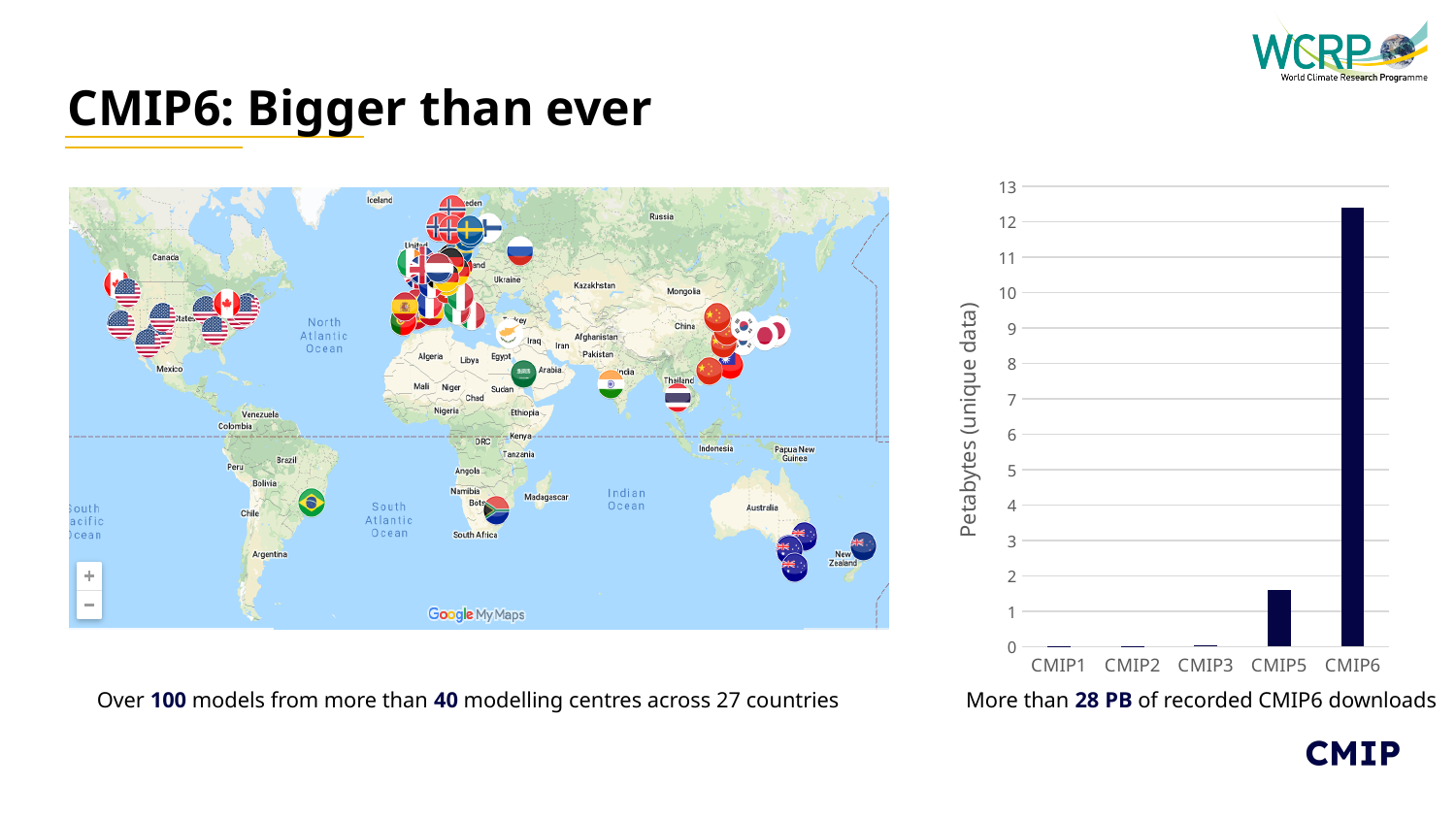
What is the highest tick value shown on the y axis of the bar chart? 13 Is the value for CMIP3 in the bar chart greater or less than 1? less Is the value for CMIP6 in the bar chart greater or less than 10? greater Is the value for CMIP5 in the bar chart greater or less than 1? greater Which is larger in the bar chart, the value for CMIP5 or the value for CMIP6? CMIP6 How many CMIP phases are shown on the x axis of the bar chart? 5 What kind of chart is shown on the right of the slide? bar chart What is the label on the y axis of the bar chart? Petabytes (unique data) Which is larger in the bar chart, the value for CMIP3 or the value for CMIP5? CMIP5 Do the values in the bar chart rise or fall from CMIP1 to CMIP6? rise Which CMIP phase has the highest value in the bar chart? CMIP6